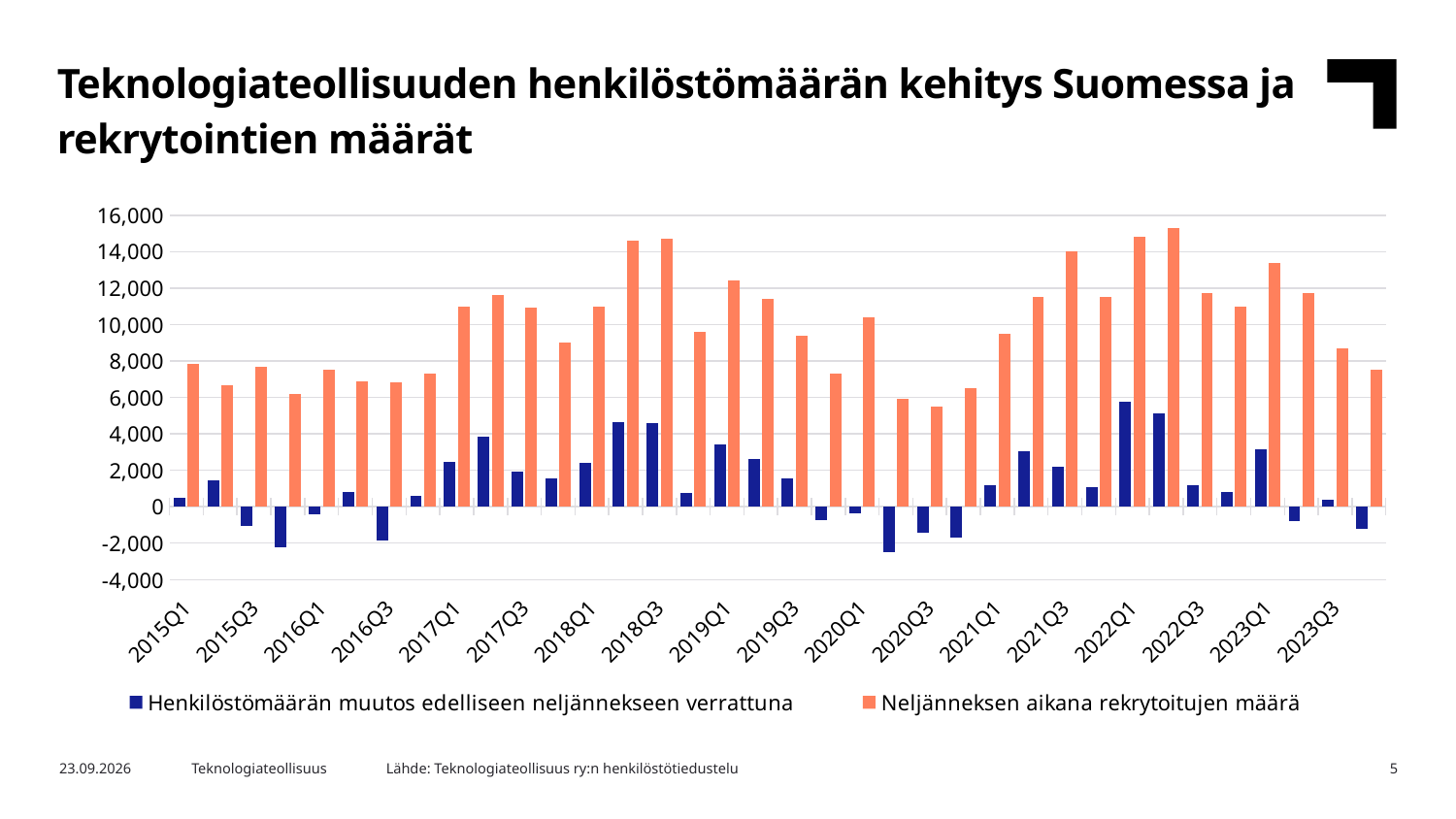
Is the value of Henkilöstömäärän muutos edelliseen neljännekseen verrattuna for 2022Q1 greater or less than 4,000? greater Which series is shown in orange according to the legend? Neljänneksen aikana rekrytoitujen määrä What kind of chart is shown on the slide? Bar chart Is the value of Neljänneksen aikana rekrytoitujen määrä for 2020Q3 greater or less than 6,000? less Is the value of Neljänneksen aikana rekrytoitujen määrä for 2018Q3 greater or less than 14,000? greater How many series does the legend list? 2 Which is larger, the value of Neljänneksen aikana rekrytoitujen määrä for 2018Q3 or for 2020Q3? 2018Q3 How many quarter labels are printed on the x axis? 18 Which is larger, the value of Henkilöstömäärän muutos edelliseen neljännekseen verrattuna for 2022Q1 or for 2023Q1? 2022Q1 Among the labeled quarters, which quarter has the highest value of Henkilöstömäärän muutos edelliseen neljännekseen verrattuna? 2022Q1